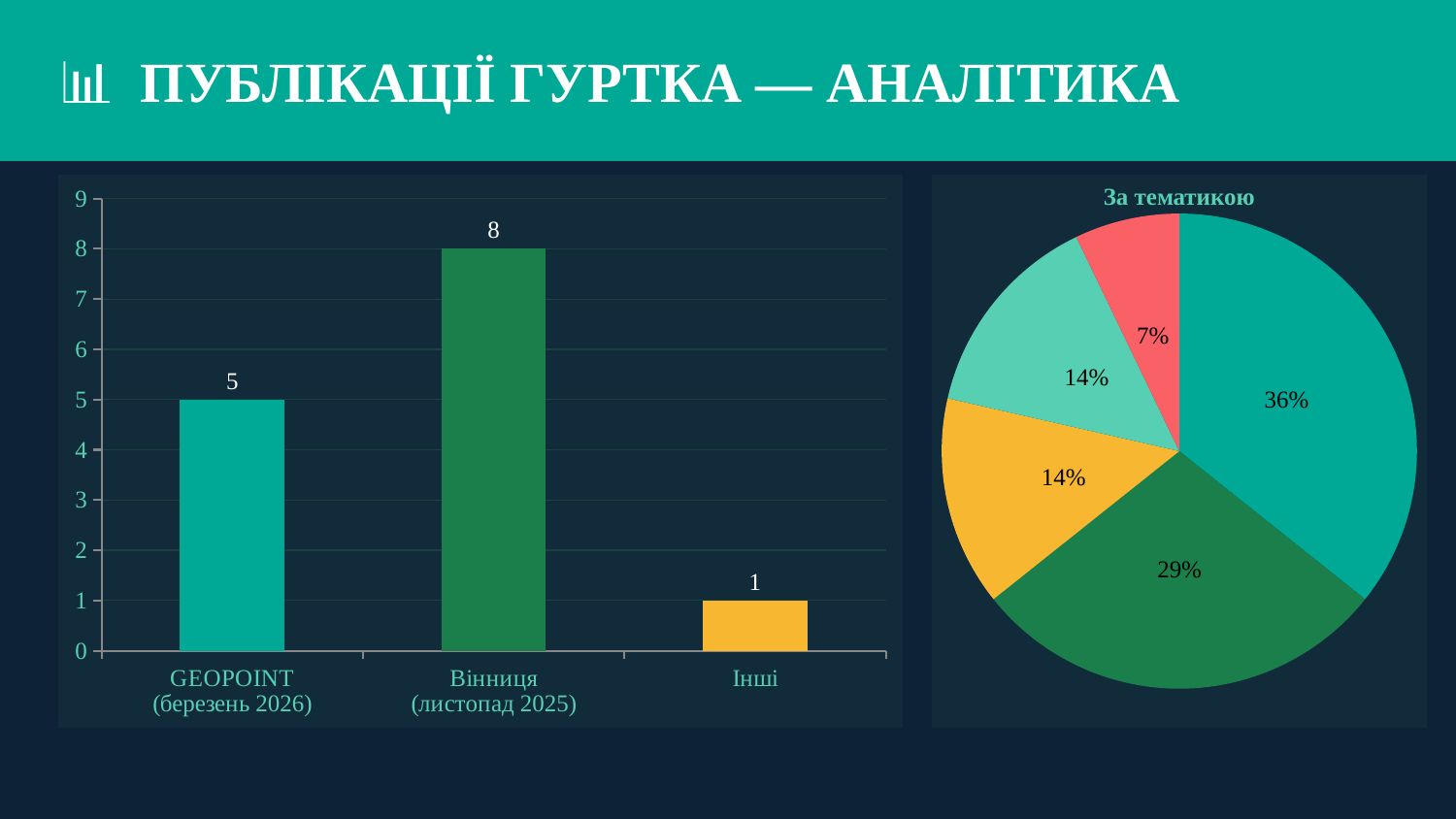
In the bar chart on the left, what is the value for Вінниця (листопад 2025)? 8 What is the title of the pie chart on the right? За тематикою What kind of chart is the chart on the left of the slide? Bar chart How many categories are shown in the bar chart on the left? 3 In the bar chart on the left, which category has the lowest value? Інші In the bar chart on the left, what is the value for GEOPOINT (березень 2026)? 5 How many slices does the pie chart 'За тематикою' have? 5 In the bar chart on the left, which category has the highest value? Вінниця (листопад 2025) In the bar chart on the left, what is the value for Інші? 1 In the bar chart on the left, which is larger: the value for GEOPOINT (березень 2026) or the value for Інші? GEOPOINT (березень 2026) In the pie chart 'За тематикою', what is the share of the largest slice? 36% In the bar chart on the left, what is the difference between the values for Вінниця (листопад 2025) and GEOPOINT (березень 2026)? 3